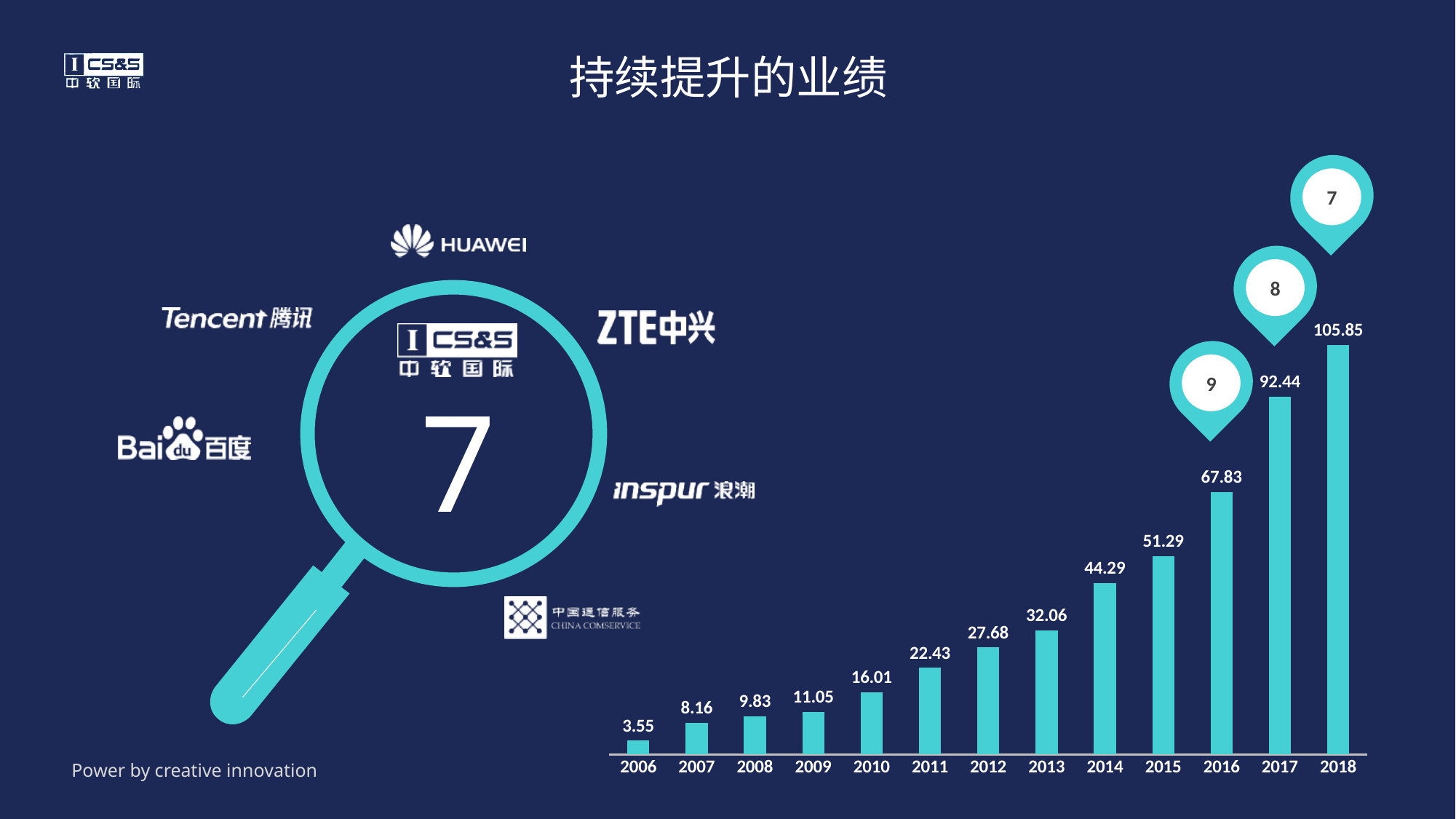
Which year has the highest value in the bar chart? 2018 What kind of chart is shown on the slide? bar chart What is the difference between the values for 2018 and 2017? 13.41 How many years are shown on the x axis of the bar chart? 13 Which is larger, the value for 2014 or the value for 2013? 2014 What is the value for 2018 in the bar chart? 105.85 Do the values rise or fall from 2006 to 2018? rise What is the difference between the values for 2016 and 2015? 16.54 What is the value for 2012 in the bar chart? 27.68 Which year has the lowest value in the bar chart? 2006 What is the value for 2015 in the bar chart? 51.29 What is the value for 2006 in the bar chart? 3.55